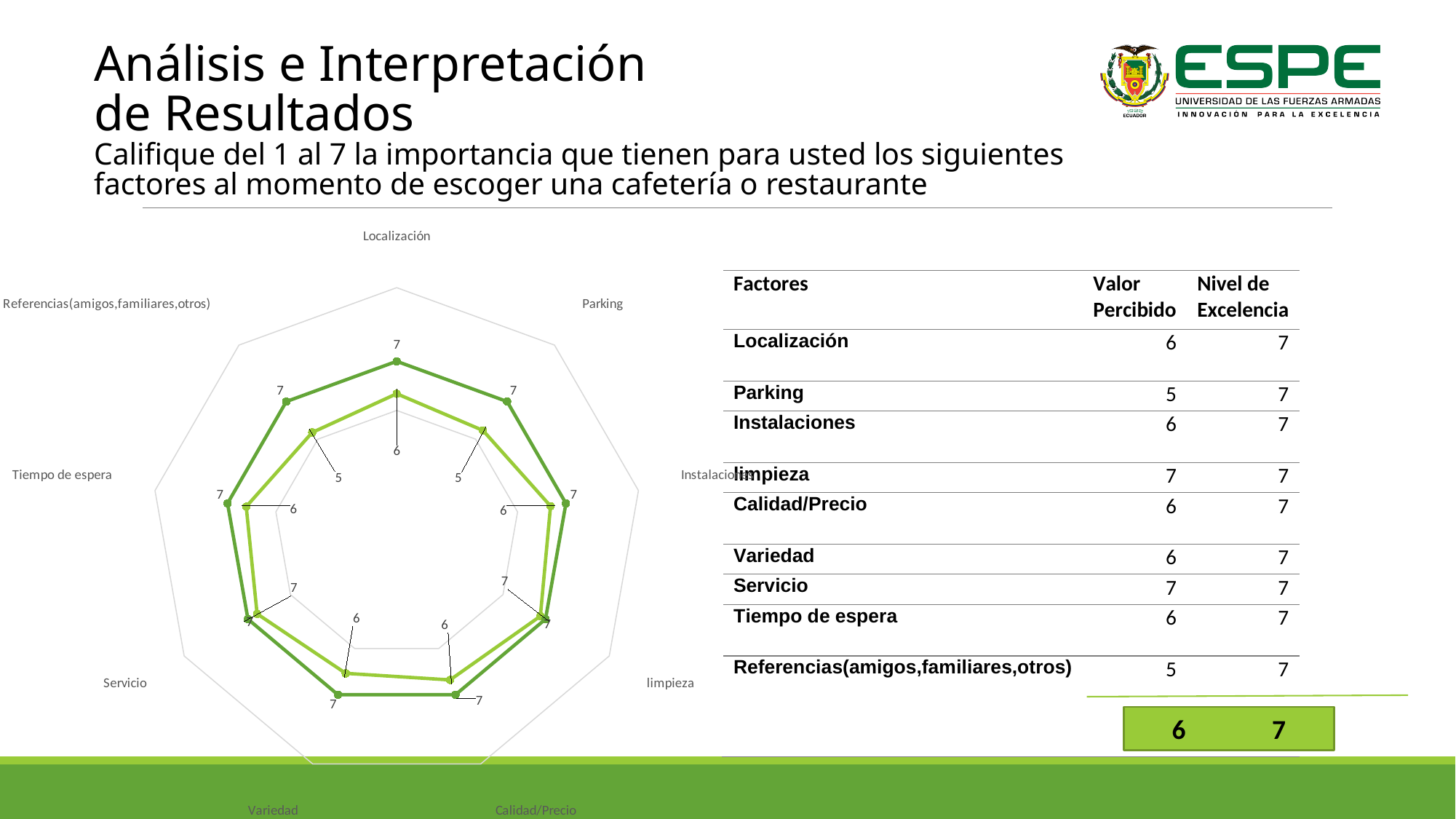
How many data series are plotted on the radar chart? 2 On the radar chart, what is the difference between the outer and inner series values for Referencias(amigos,familiares,otros)? 2 On the radar chart, what is the value of the inner (light green) series for Servicio? 7 On the radar chart, what is the value of the inner (light green) series for limpieza? 7 On the radar chart, what is the value of the inner (light green) series for Parking? 5 How many categories (axes) does the radar chart have? 9 On the radar chart, what is the value of the inner (light green) series for Referencias(amigos,familiares,otros)? 5 On the radar chart, what value does the outer (dark green) series have at every category? 7 On the radar chart, what is the value of the outer (dark green) series for Localización? 7 On the radar chart, which is larger for the inner (light green) series: Parking or limpieza? limpieza On the radar chart, what is the difference between the inner (light green) series values for limpieza and Parking? 2 What kind of chart is shown on the left of the slide? Radar chart